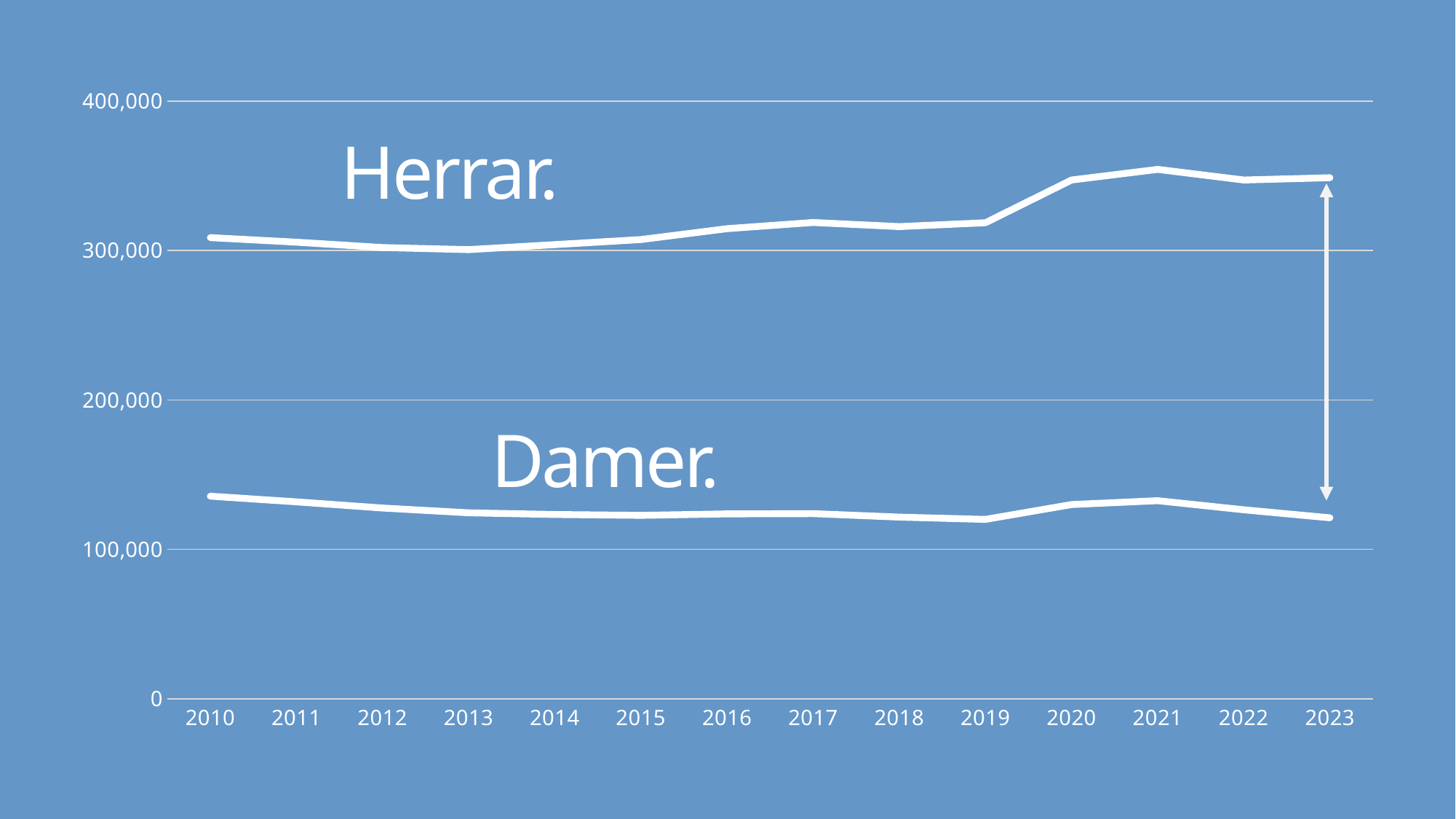
Is the value for Herrar in 2021 greater or less than 400,000? less Is the value for Damer in 2023 greater or less than 100,000? greater How many series are plotted on the chart? 2 What are the names of the two series on the chart? Herrar and Damer Is the value for Damer in 2010 greater or less than 200,000? less Which series has the higher value in 2023, Herrar or Damer? Herrar In which year does the Herrar series reach its highest value? 2021 For Herrar, which year has the higher value, 2013 or 2021? 2021 Does the Damer series rise or fall from 2010 to 2019? Fall How many years are shown on the x axis? 14 What kind of chart is shown on the slide? Line chart